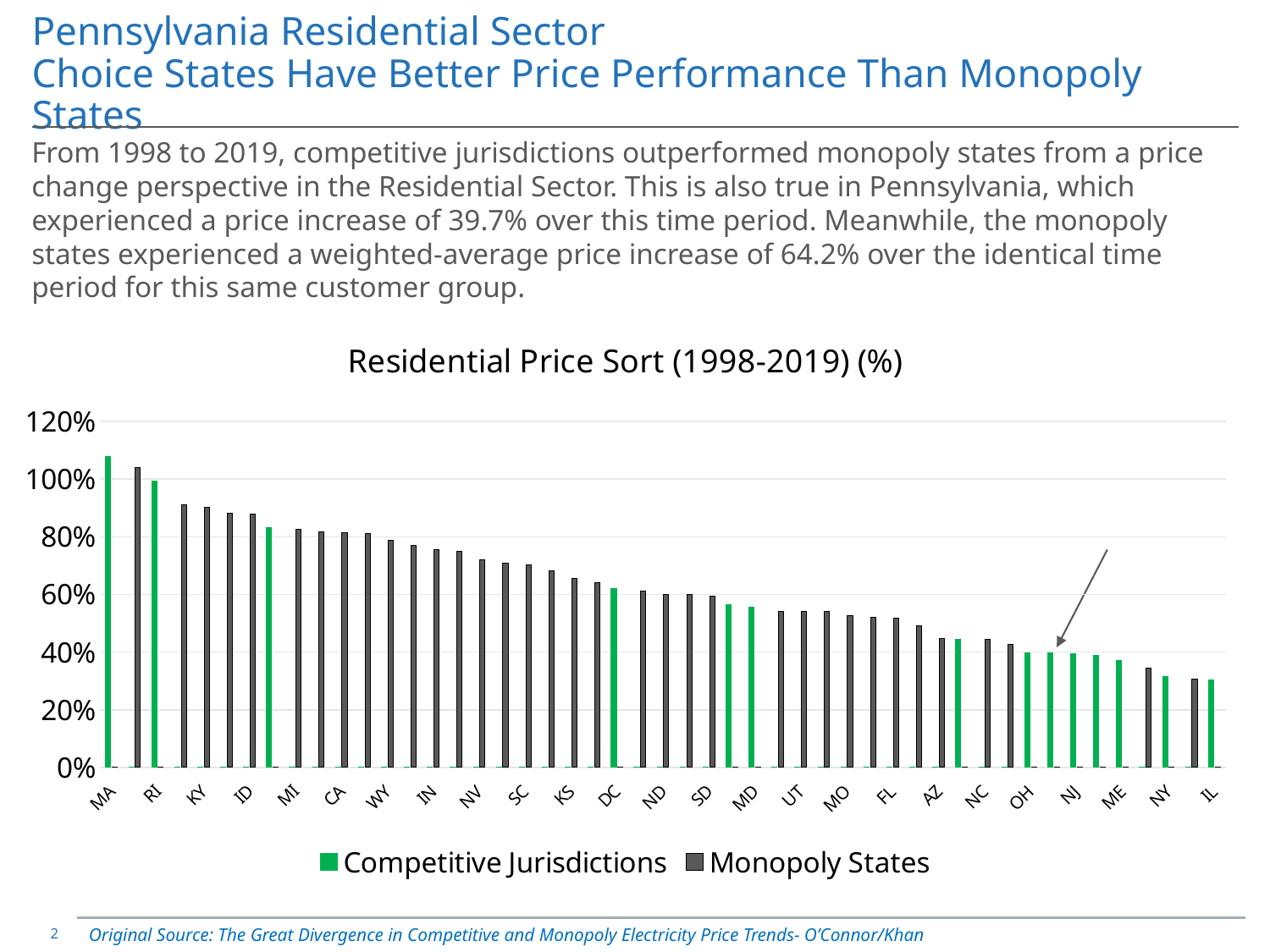
Is the value for IL greater or less than 40%? less Is the value for OH greater or less than 60%? less Is the value for NV greater or less than 60%? greater Do the values rise or fall moving from left to right along the x axis? Fall What kind of chart is shown on the slide? Bar chart Which series does the bar for MA belong to, according to its colour? Competitive Jurisdictions What are the two series named in the legend of the chart? Competitive Jurisdictions and Monopoly States Which has the larger value, MA or IL? MA Which state has the highest value in the Residential Price Sort chart? MA How many series does the legend of the Residential Price Sort chart list? 2